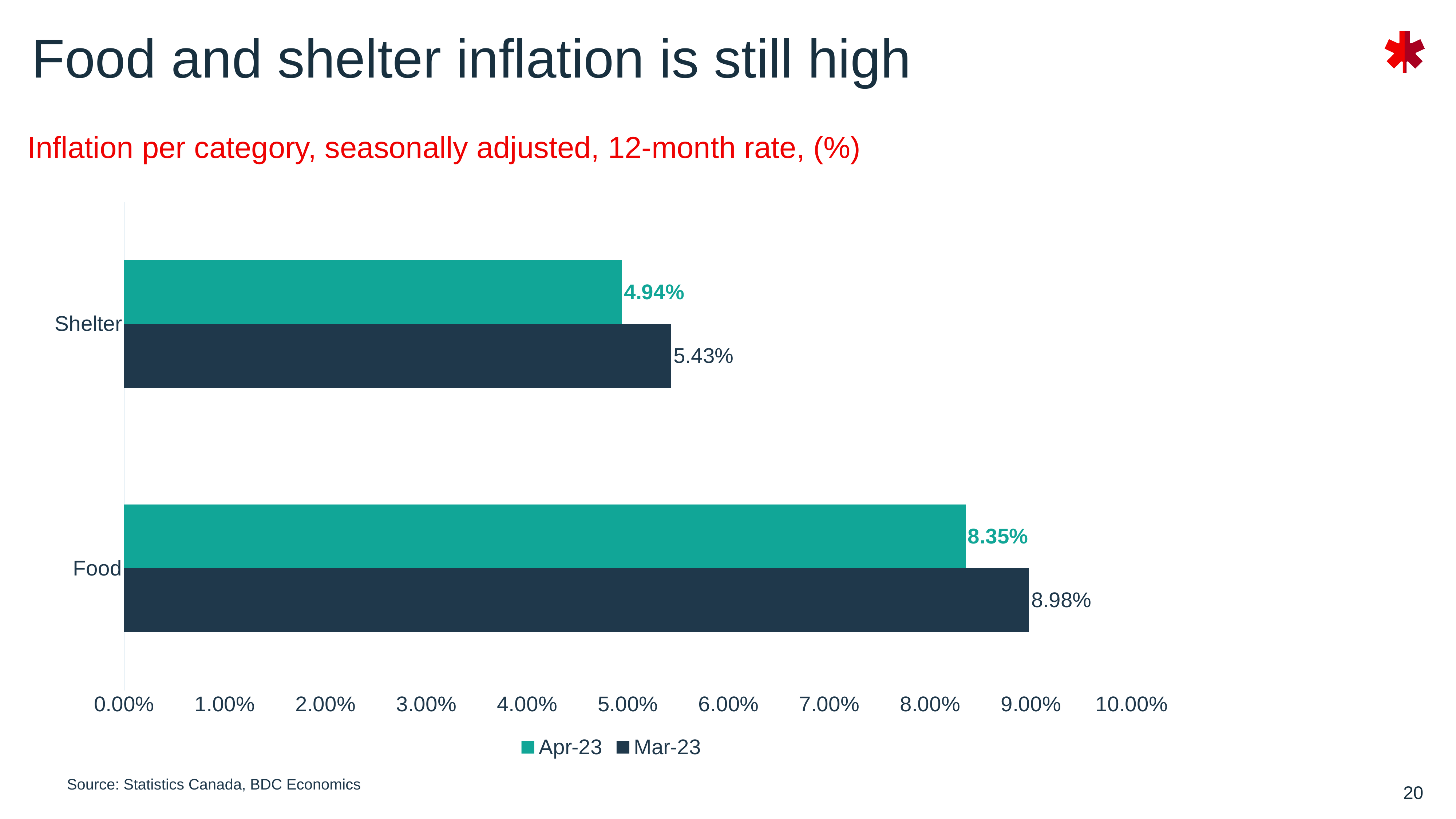
What is the difference between the Mar-23 and Apr-23 inflation rates for Shelter? 0.49% How many series does the legend list? 2 Which category has the lowest Apr-23 inflation rate? Shelter What type of chart is shown on the slide? bar chart What is the Mar-23 inflation rate for Shelter? 5.43% What is the Mar-23 inflation rate for Food? 8.98% What is the Apr-23 inflation rate for Shelter? 4.94% How many categories are shown on the chart? 2 Which category has the highest Mar-23 inflation rate? Food What is the difference between the Mar-23 and Apr-23 inflation rates for Food? 0.63% What is the Apr-23 inflation rate for Food? 8.35% Is the Apr-23 inflation rate for Shelter higher or lower than the Mar-23 rate for Shelter? lower